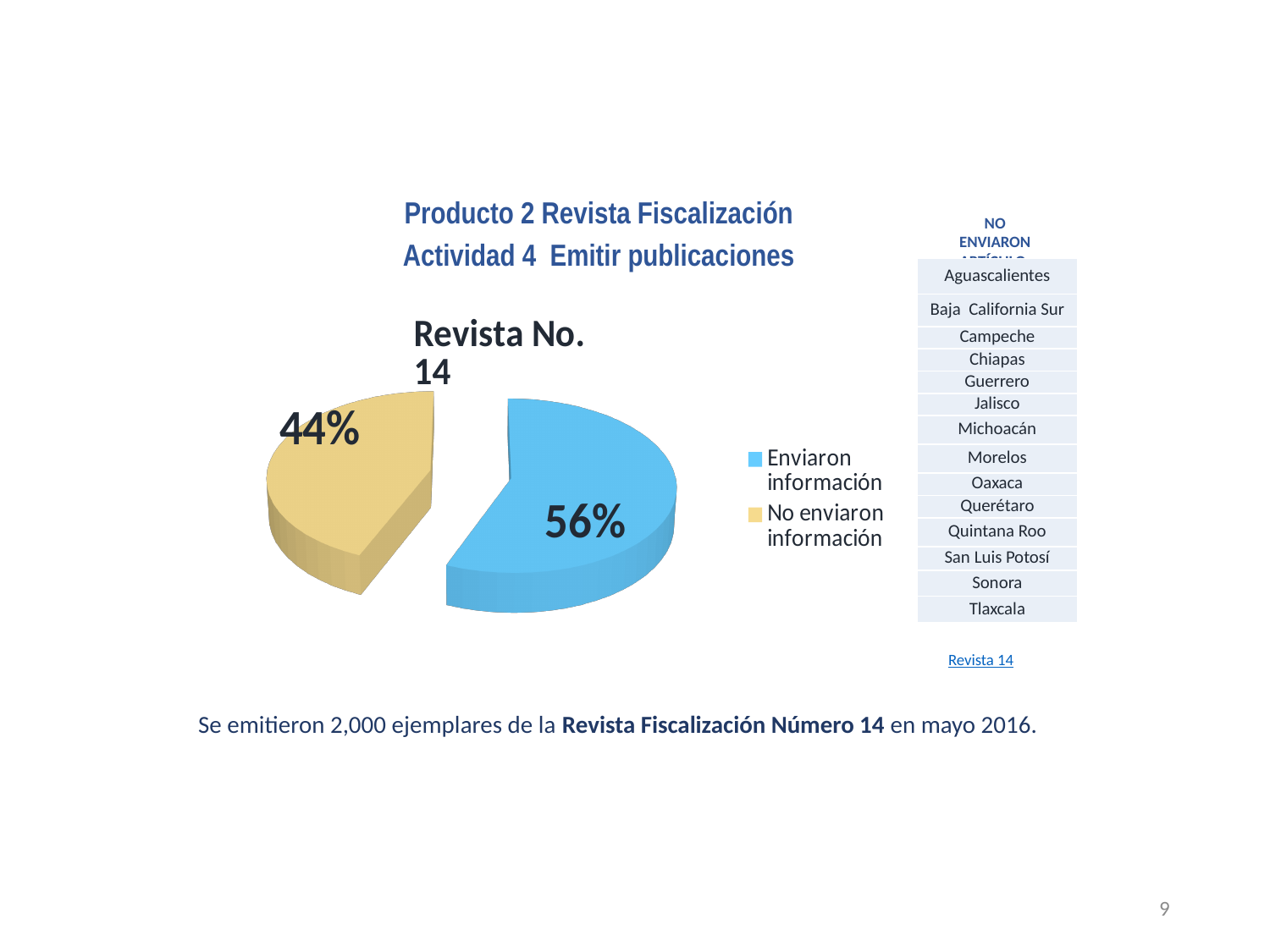
What is the title of the pie chart? Revista No. 14 Which slice of the pie chart is the largest? Enviaron información How many entries does the legend of the pie chart list? 2 What type of chart is shown on the slide? pie chart Which slice of the pie chart is the smallest? No enviaron información Which is larger: the "Enviaron información" slice or the "No enviaron información" slice? Enviaron información How many slices does the pie chart have? 2 What colour is the "No enviaron información" slice in the pie chart? yellow What share of the pie is labelled "No enviaron información"? 44% What is the difference in percentage points between the "Enviaron información" and "No enviaron información" slices? 12 percentage points Is the share for "Enviaron información" greater or less than 50%? greater What share of the pie is labelled "Enviaron información"? 56%